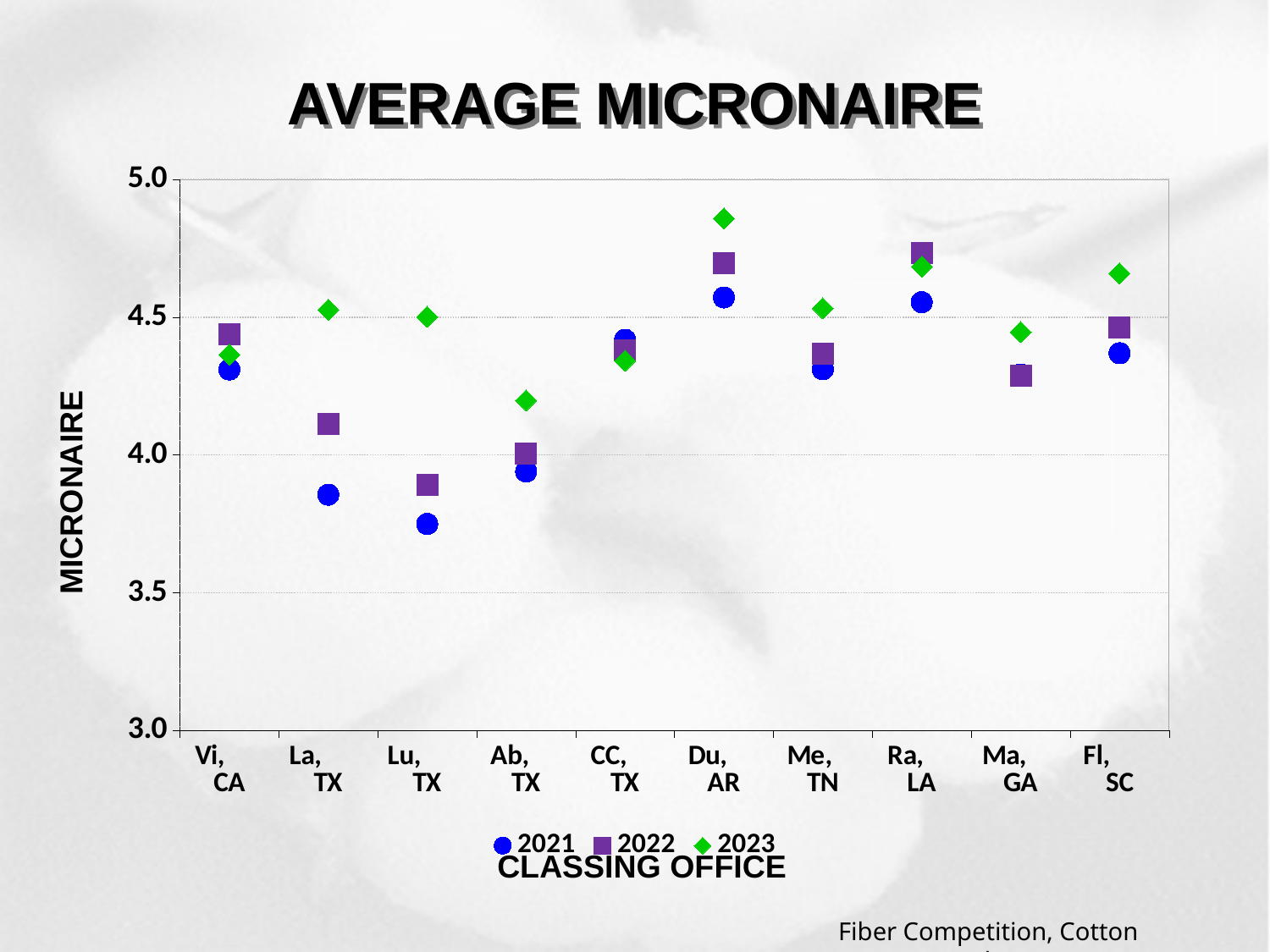
Which classing office has the lowest 2021 micronaire value? Lu, TX What is the title of the chart? AVERAGE MICRONAIRE Is the 2023 value for Fl, SC greater or less than 4.5? greater For Lu, TX, which is larger: the 2021 value or the 2022 value? 2022 Which classing office has the highest 2023 micronaire value? Du, AR Is the 2022 value for Ma, GA greater or less than 4.5? less Which classing office has the lowest 2023 micronaire value? Ab, TX What kind of chart is shown on the slide? Scatter chart How many classing offices are shown on the x axis? 10 Is the 2023 value for Du, AR greater or less than 4.5? greater How many series does the legend list? 3